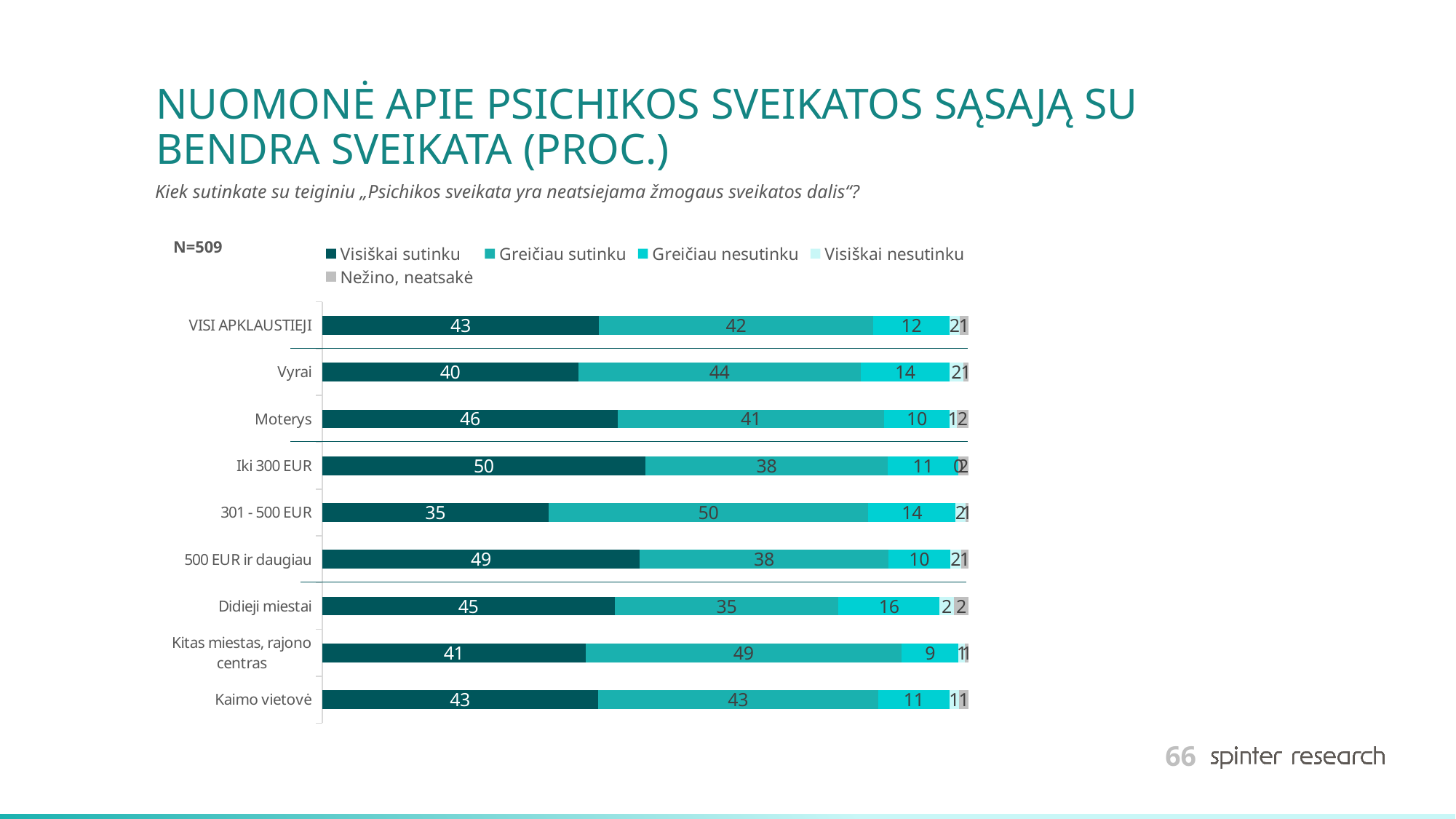
How many series does the legend list? 5 What kind of chart is shown on the slide? Stacked bar chart What is the difference between the "Visiškai sutinku" values for Moterys and Vyrai? 6 How many categories are shown on the chart? 9 What is the value of "Greičiau nesutinku" for Kitas miestas, rajono centras? 9 What is the value of "Visiškai sutinku" for Moterys? 46 What sample size (N) is stated on the slide? N=509 What is the value of "Greičiau nesutinku" for Didieji miestai? 16 Which has a larger "Greičiau sutinku" value, Vyrai or Moterys? Vyrai Which category has the highest "Visiškai sutinku" value? Iki 300 EUR What is the value of "Greičiau sutinku" for 301 - 500 EUR? 50 Which category has the lowest "Visiškai sutinku" value? 301 - 500 EUR